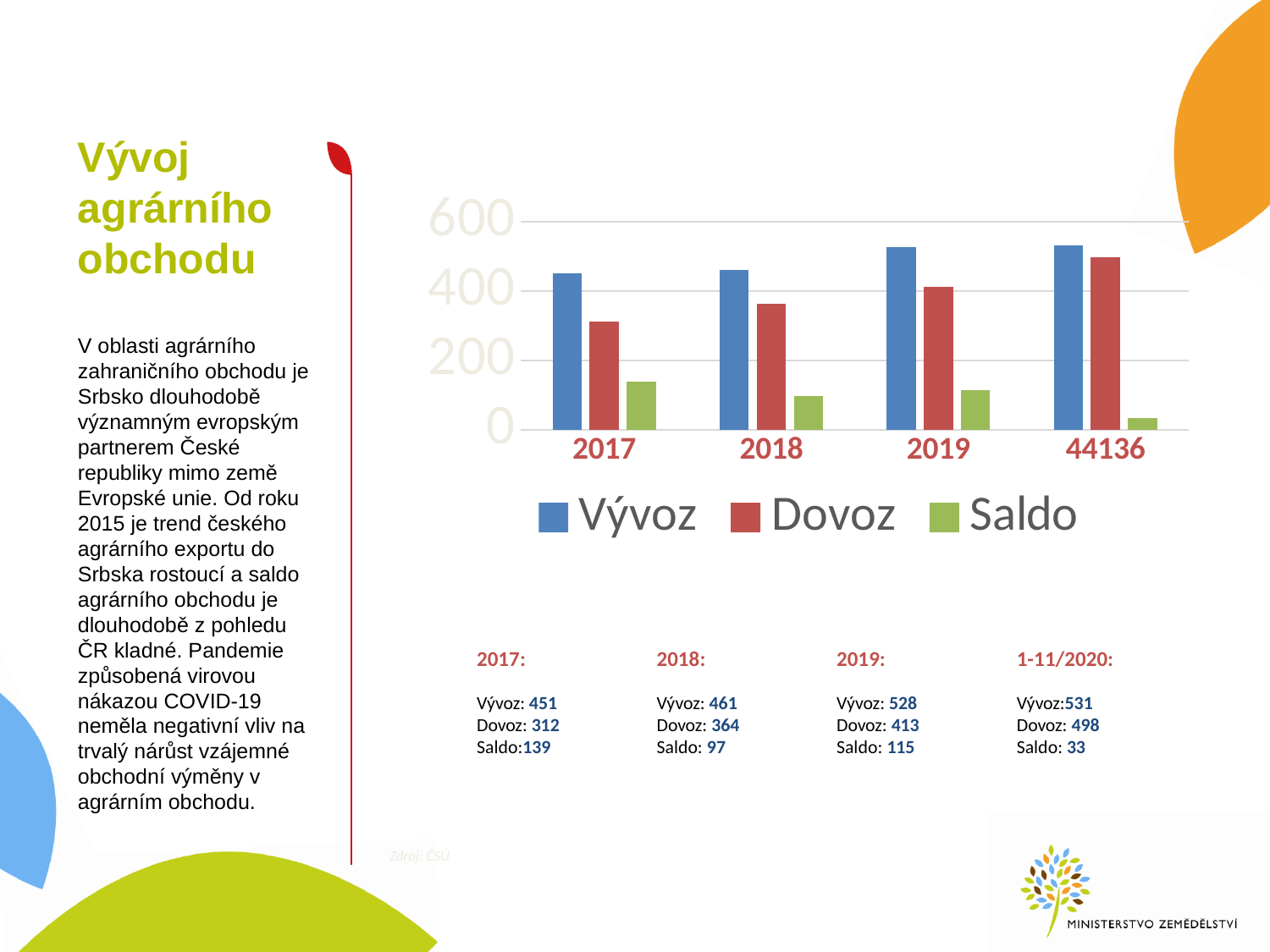
Which is larger in 2019, the Vývoz bar or the Dovoz bar? Vývoz Is the Saldo value for 2019 greater or less than 200? less What kind of chart is shown on the slide? bar chart Is the Vývoz value for 2017 greater or less than 400? greater Does the Vývoz series rise or fall across the x axis from 2017 to 44136? rise Is the Dovoz value for 2018 greater or less than 400? less Which colour represents Saldo in the chart? green How many series does the chart legend list? 3 What are the three series named in the chart legend? Vývoz, Dovoz, Saldo Which category has the highest Vývoz bar? 44136 Which category has the lowest Saldo bar? 44136 How many categories are shown on the x axis of the chart? 4